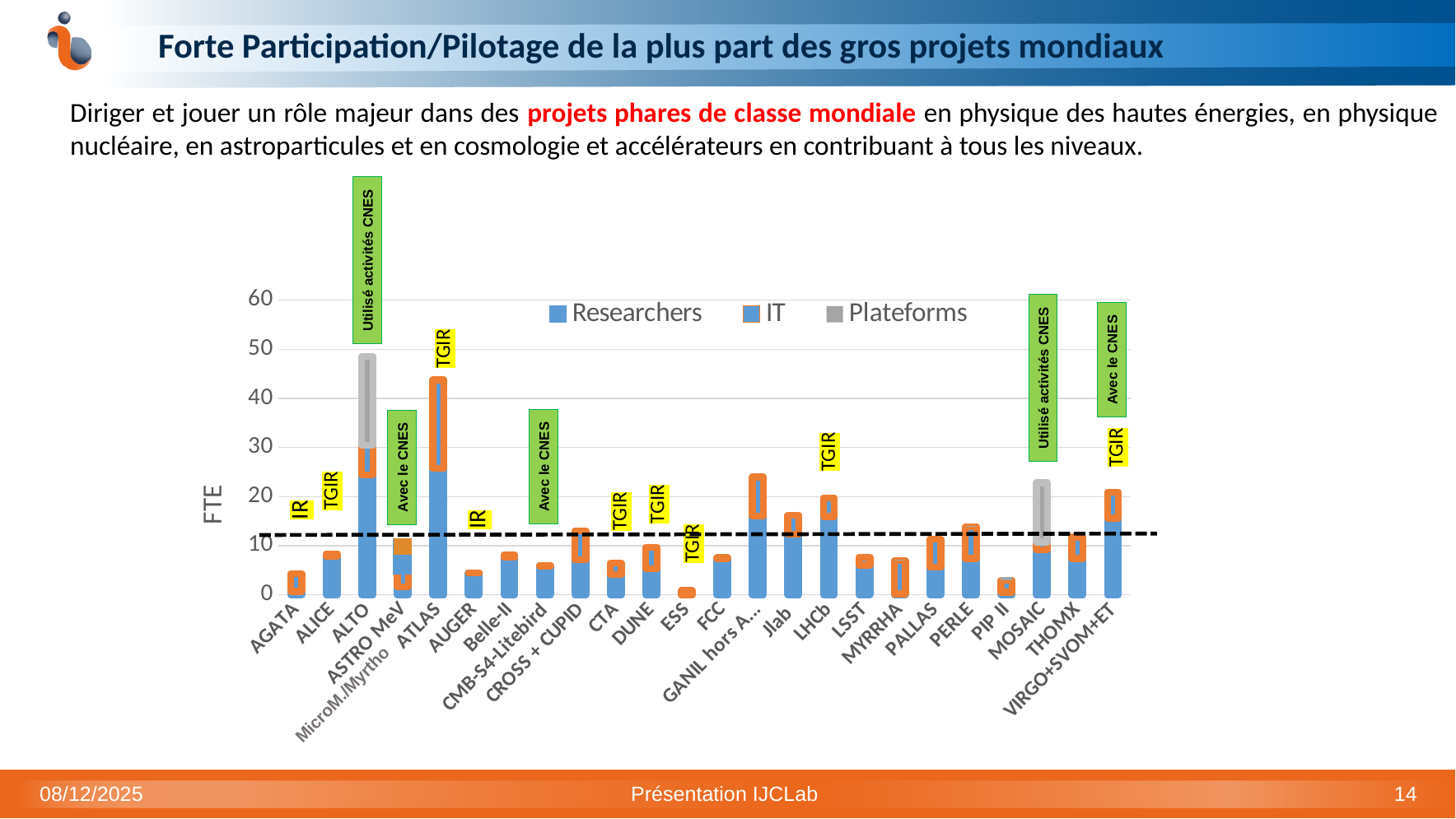
Which project has the tallest total bar in the chart? ALTO Which project has the shortest total bar in the chart? ESS Is the total value for AGATA greater or less than 10? less Which has the larger total bar, ATLAS or LHCb? ATLAS What is the label of the vertical axis of the chart? FTE Is the total value for ESS greater or less than 10? less Is the total value for ATLAS greater or less than 40? greater How many project categories are shown along the x axis of the chart? 24 How many series does the chart legend list? 3 What are the series names listed in the chart legend? Researchers, IT, Plateforms What kind of chart is shown on the slide? Stacked bar chart